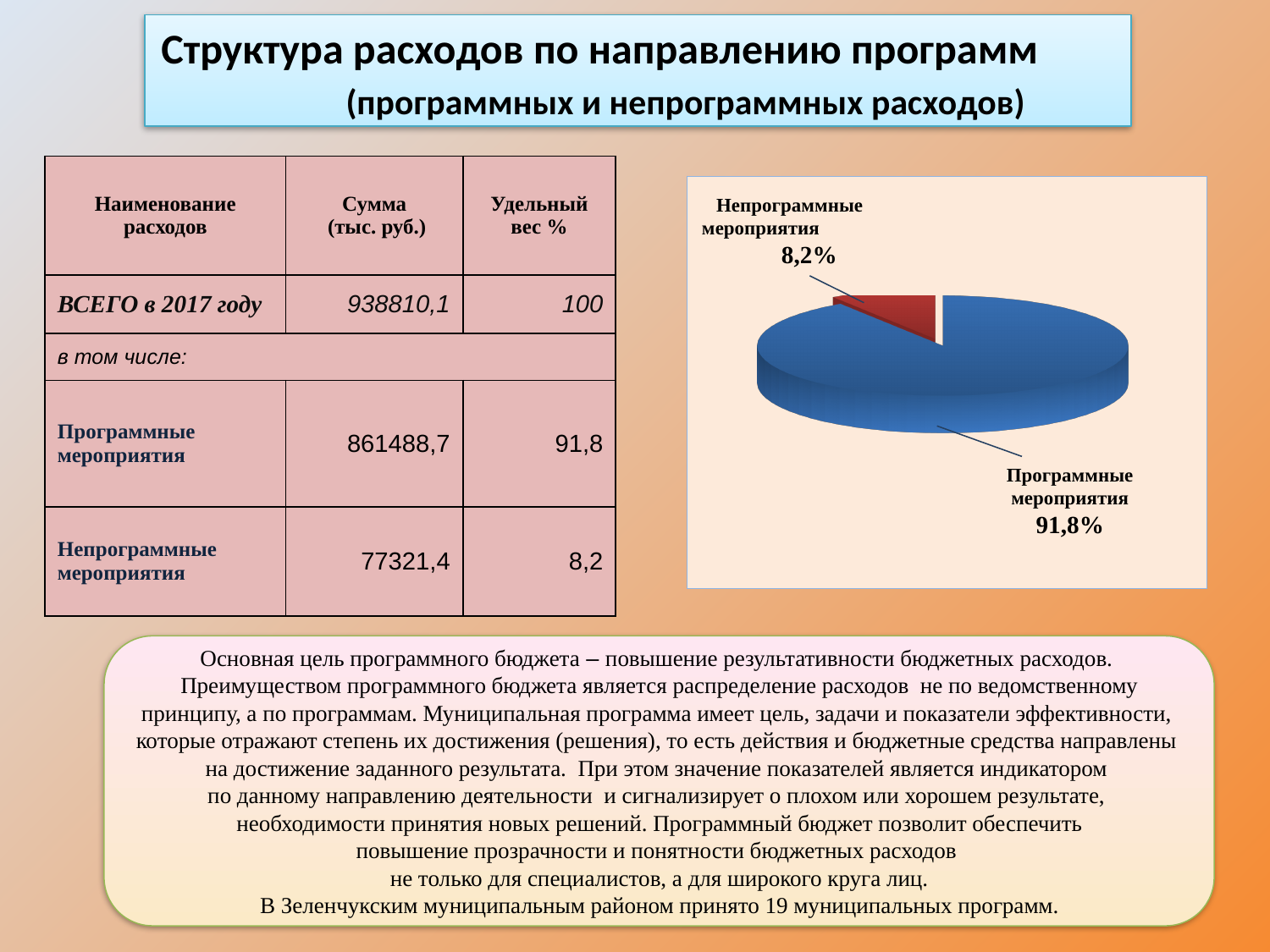
What share of the pie does "Программные мероприятия" have? 91,8% What colour is the "Непрограммные мероприятия" slice in the pie chart? red What share of the pie does "Непрограммные мероприятия" have? 8,2% What colour is the "Программные мероприятия" slice in the pie chart? blue How many slices does the pie chart have? 2 Which is larger in the pie chart: "Программные мероприятия" or "Непрограммные мероприятия"? Программные мероприятия What kind of chart is shown on the slide? pie chart What is the difference in percentage points between the "Программные мероприятия" and "Непрограммные мероприятия" slices? 83,6 Which slice of the pie chart is the largest? Программные мероприятия What is the total of the two slice percentages shown on the pie chart? 100% Which slice of the pie chart is the smallest? Непрограммные мероприятия